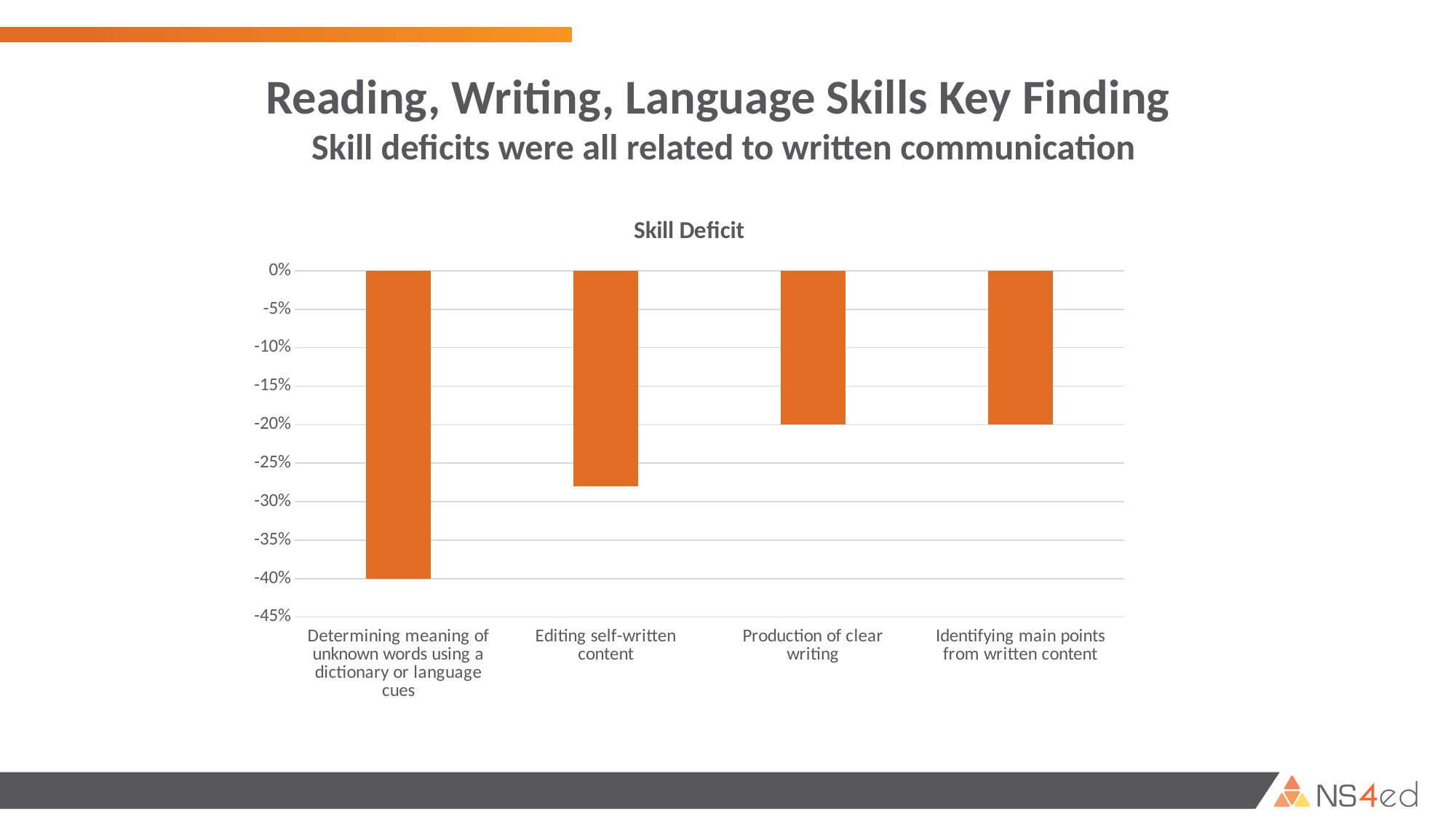
What is the title of the chart? Skill Deficit What is the difference between the values for Determining meaning of unknown words using a dictionary or language cues and Production of clear writing? 20 percentage points Is the value for Editing self-written content greater or less than -25%? less How many categories are shown in the chart? 4 What is the value for Production of clear writing? -20% What kind of chart is shown on the slide? bar chart Which has the larger deficit: Editing self-written content or Production of clear writing? Editing self-written content What is the value for Identifying main points from written content? -20% What is the lowest value shown on the vertical axis? -45% Do the values rise or fall from left to right across the categories? rise What is the value for Determining meaning of unknown words using a dictionary or language cues? -40% Which category has the largest skill deficit (the lowest value)? Determining meaning of unknown words using a dictionary or language cues